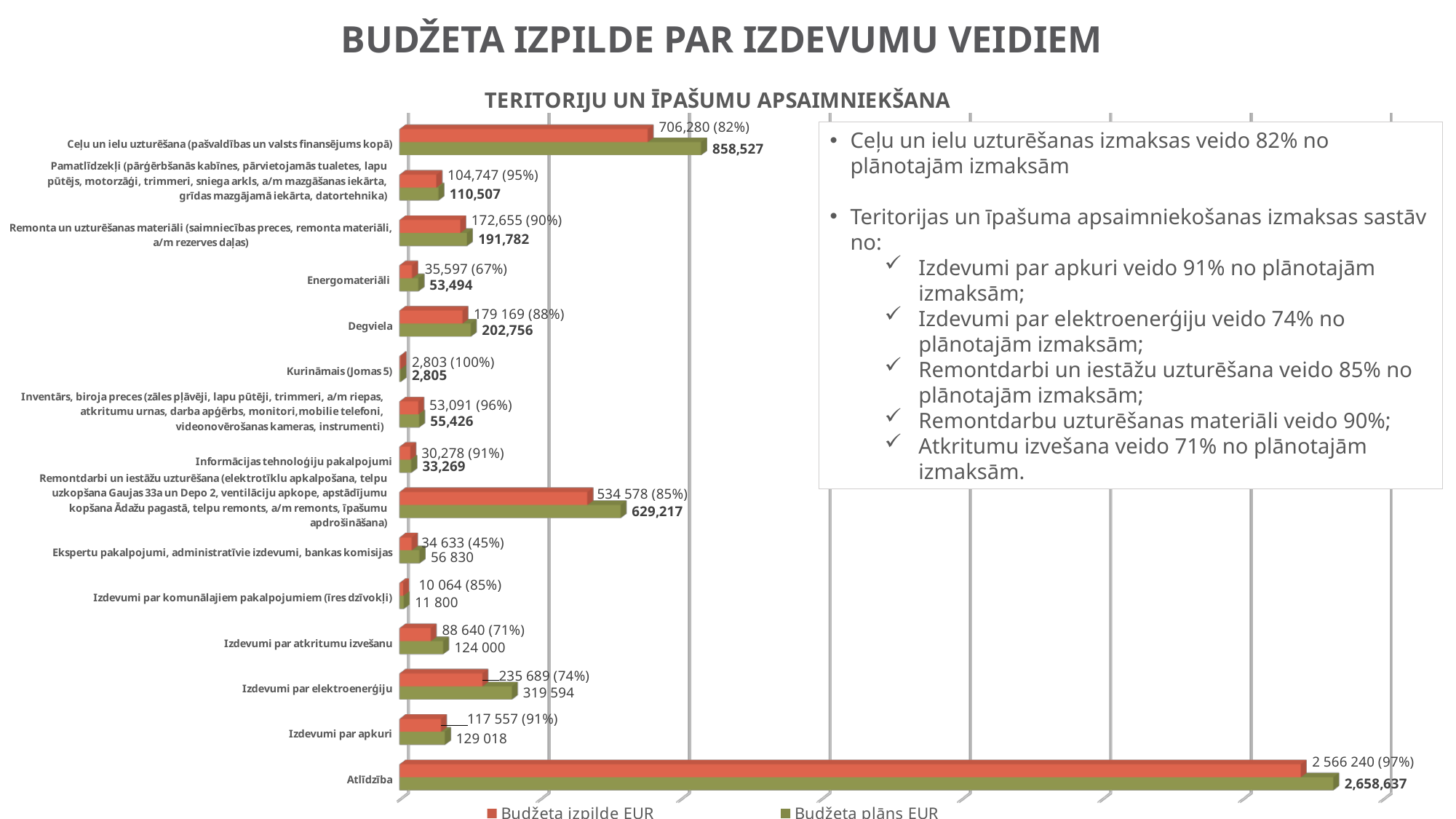
How many series does the chart legend list? 2 What is the Budžeta plāns EUR value for Energomateriāli? 53,494 Which category has the highest Budžeta plāns EUR value? Atlīdzība What is the Budžeta plāns EUR value for Atlīdzība? 2,658,637 How many categories are plotted on the chart? 15 Which category has the lowest Budžeta plāns EUR value? Kurināmais (Jomas 5) What is the difference between the Budžeta plāns EUR and Budžeta izpilde EUR values for Izdevumi par apkuri? 11 461 What is the Budžeta izpilde EUR value for Izdevumi par elektroenerģiju? 235 689 What is the Budžeta izpilde EUR value for Degviela? 179 169 What is the title of the chart? TERITORIJU UN ĪPAŠUMU APSAIMNIEKŠANA Which is larger: the Budžeta izpilde EUR value for Izdevumi par atkritumu izvešanu or for Ekspertu pakalpojumi, administratīvie izdevumi, bankas komisijas? Izdevumi par atkritumu izvešanu What kind of chart is shown on the slide? bar chart